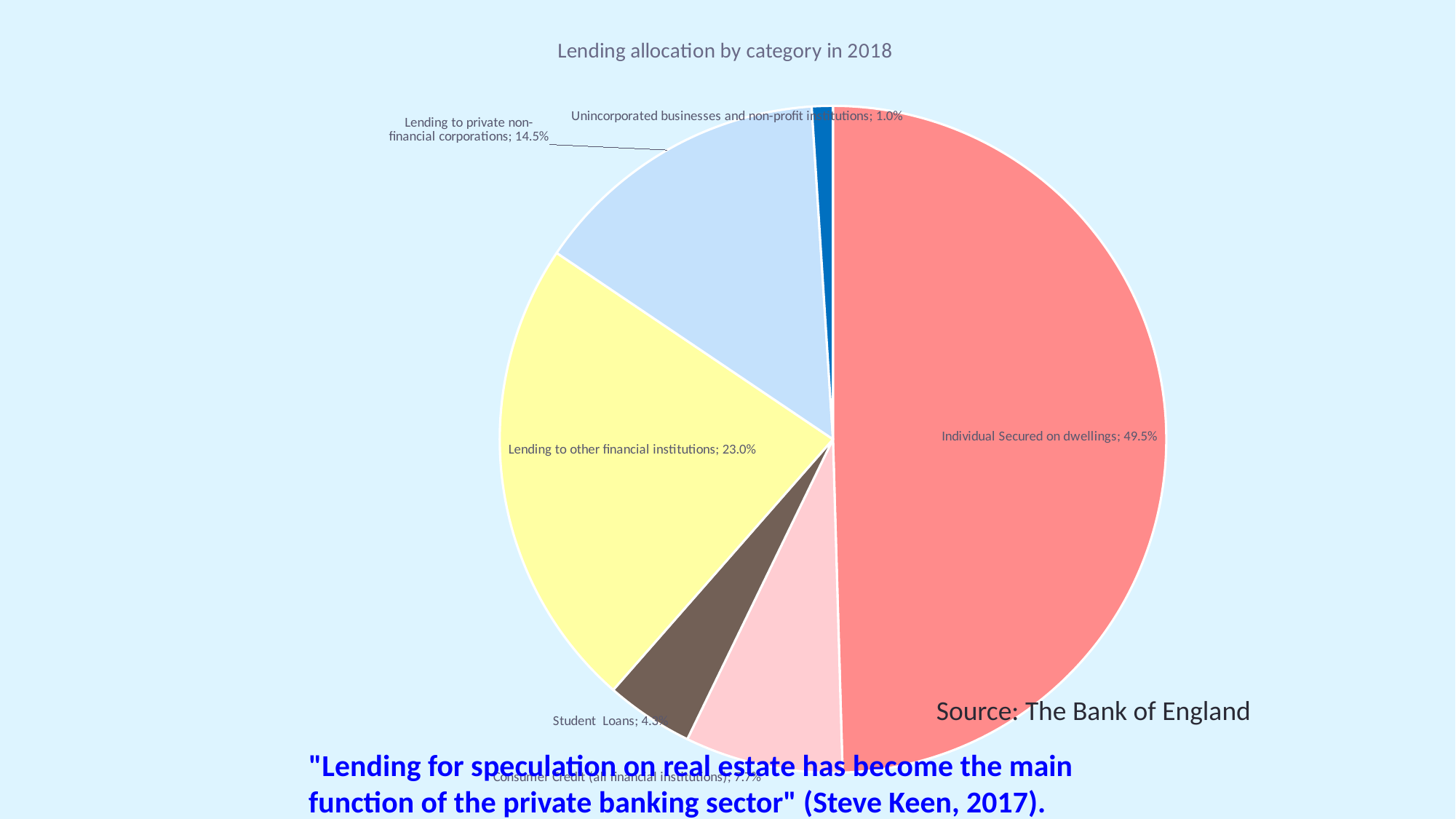
What percentage is shown for Unincorporated businesses and non-profit institutions? 1.0% How many percentage points larger is Individual Secured on dwellings than Lending to other financial institutions? 26.5 percentage points What percentage of lending goes to Lending to other financial institutions? 23.0% What is the source of the data cited on the slide? The Bank of England How many categories (slices) does the pie chart have? 6 What share of lending is Lending to private non-financial corporations? 14.5% What percentage of lending is allocated to Individual Secured on dwellings? 49.5% What kind of chart is shown on the slide? Pie chart Which category has the smallest slice of the pie? Unincorporated businesses and non-profit institutions What is the title of the chart? Lending allocation by category in 2018 Which is larger: Lending to other financial institutions or Lending to private non-financial corporations? Lending to other financial institutions Which category has the largest slice of the pie? Individual Secured on dwellings